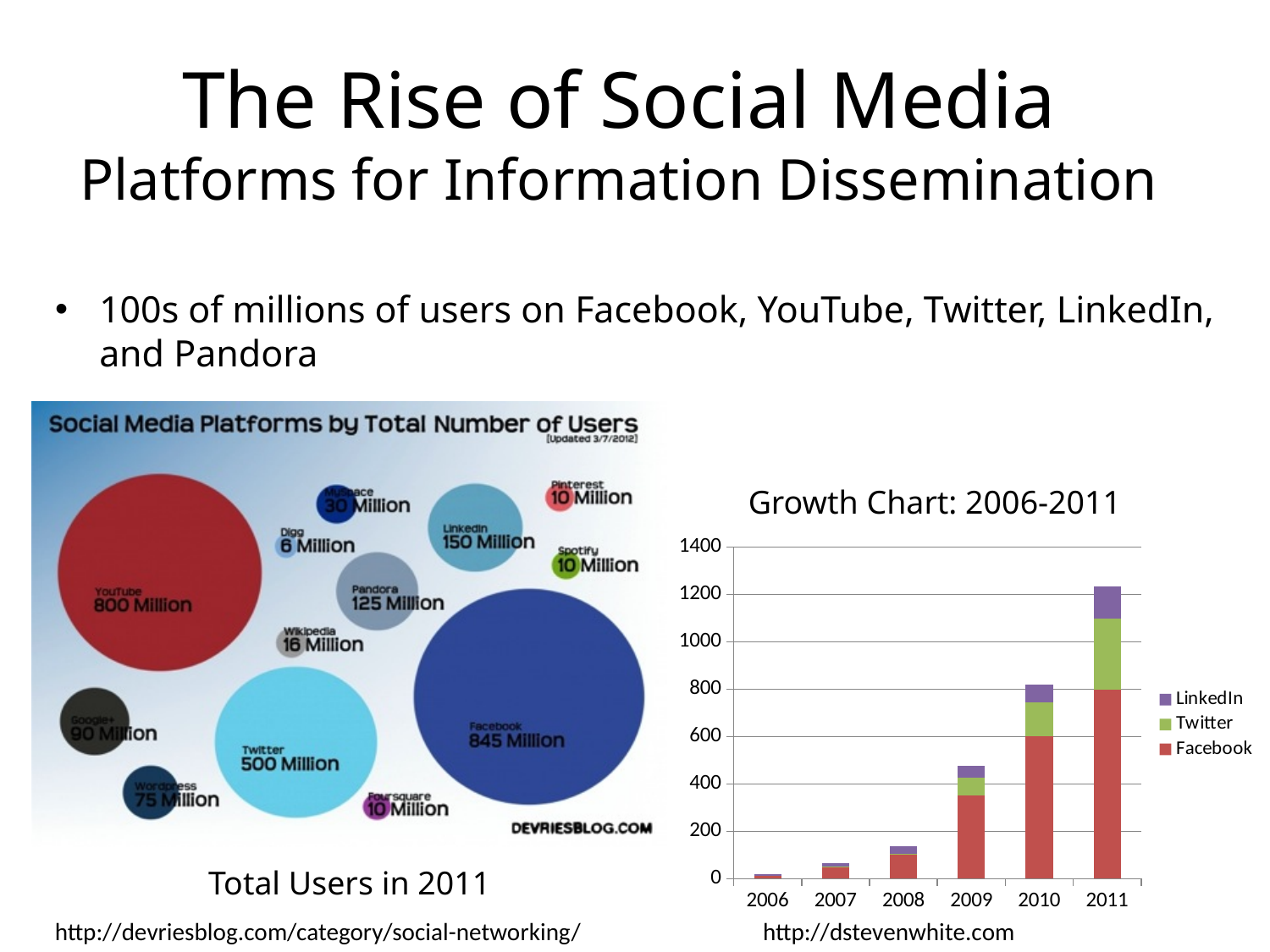
In the 'Social Media Platforms by Total Number of Users' chart, what is the difference in users between Facebook and Twitter? 345 Million In the 'Social Media Platforms by Total Number of Users' chart, which has more users, LinkedIn or Google+? LinkedIn How many years are shown on the x axis of the 'Growth Chart: 2006-2011'? 6 In the 'Growth Chart: 2006-2011', do the stacked totals rise or fall from 2006 to 2011? Rise In the 'Growth Chart: 2006-2011', is the total for 2011 greater or less than 1200? greater In the 'Social Media Platforms by Total Number of Users' chart, how many users does Facebook have? 845 Million In the 'Social Media Platforms by Total Number of Users' chart, which platform has the fewest users? Digg In the 'Social Media Platforms by Total Number of Users' chart, how many users does Pandora have? 125 Million In the 'Social Media Platforms by Total Number of Users' chart, which platform has the most users? Facebook In the 'Social Media Platforms by Total Number of Users' chart, how many users does YouTube have? 800 Million What kind of chart is the 'Growth Chart: 2006-2011'? Stacked bar chart How many series does the legend of the 'Growth Chart: 2006-2011' list? 3